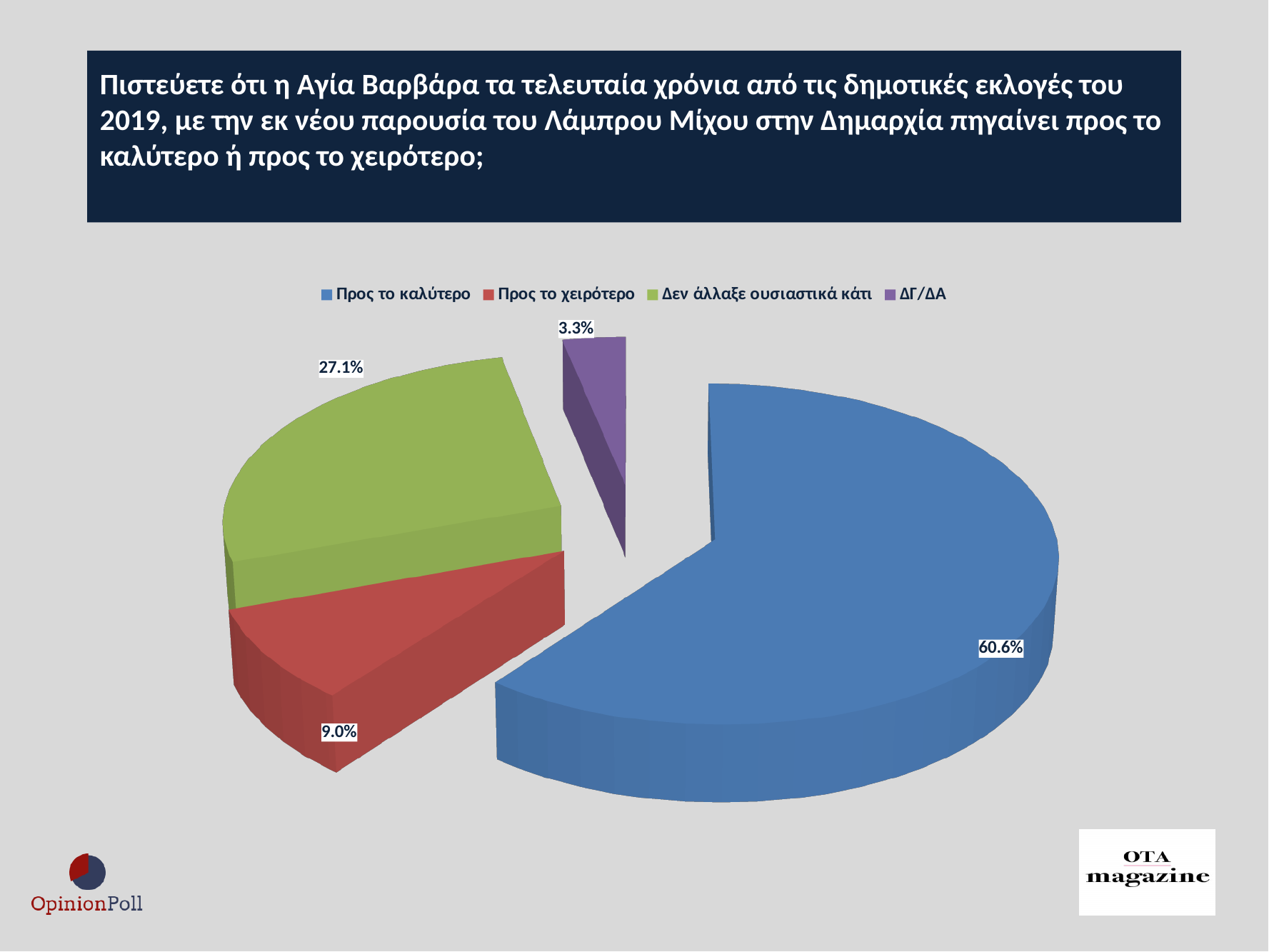
What percentage of respondents answered "Προς το καλύτερο"? 60.6% What percentage of respondents answered "Προς το χειρότερο"? 9.0% How many slices does the pie chart have? 4 Which response has the smallest share of the pie? ΔΓ/ΔΑ Which response has the largest share of the pie? Προς το καλύτερο Which is larger: the share for "Προς το χειρότερο" or the share for "Δεν άλλαξε ουσιαστικά κάτι"? Δεν άλλαξε ουσιαστικά κάτι What is the difference in percentage points between "Προς το χειρότερο" and "ΔΓ/ΔΑ"? 5.7 What percentage of respondents answered "Δεν άλλαξε ουσιαστικά κάτι"? 27.1% What kind of chart is shown on the slide? Pie chart What is the difference in percentage points between "Προς το καλύτερο" and "Δεν άλλαξε ουσιαστικά κάτι"? 33.5 What colour is the slice for "Δεν άλλαξε ουσιαστικά κάτι"? Green What percentage of respondents answered "ΔΓ/ΔΑ"? 3.3%